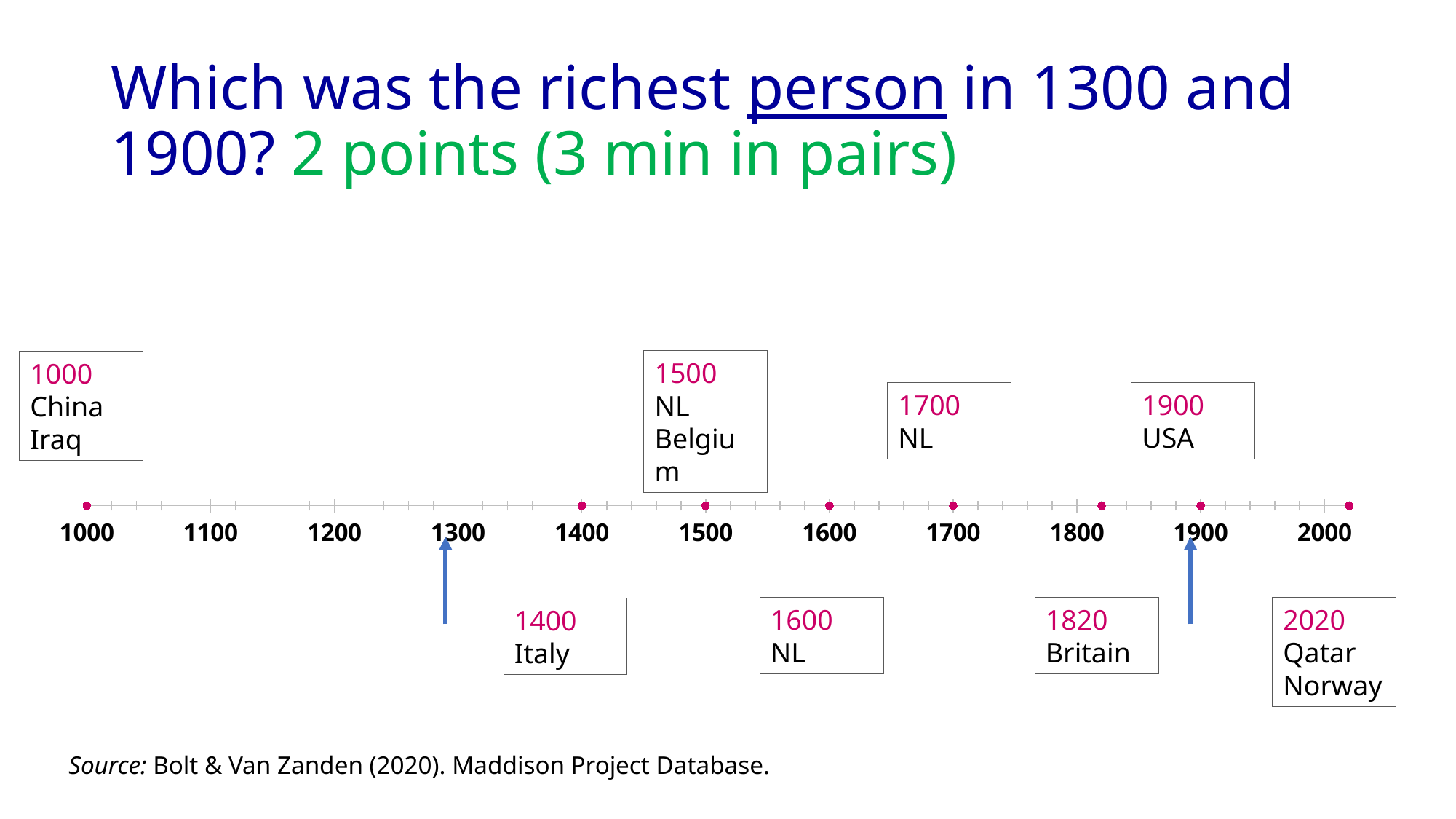
What is the latest year marked with a labelled point on the timeline? 2020 What is the earliest year marked with a labelled point on the timeline? 1000 Which country is labelled at the 1820 point on the timeline? Britain Which country is labelled as the richest at the 1400 point on the timeline? Italy Which countries are labelled at the 1500 point on the timeline? NL, Belgium What kind of chart is shown on the slide? Timeline Which country is labelled at the 1900 point on the timeline? USA In which year is Britain labelled on the timeline? 1820 Which countries are labelled at the 2020 point on the timeline? Qatar, Norway Which countries are labelled at the 1000 point on the timeline? China, Iraq Which two years on the timeline do the blue arrows point to? 1300 and 1900 How many labelled points are marked on the timeline? 8